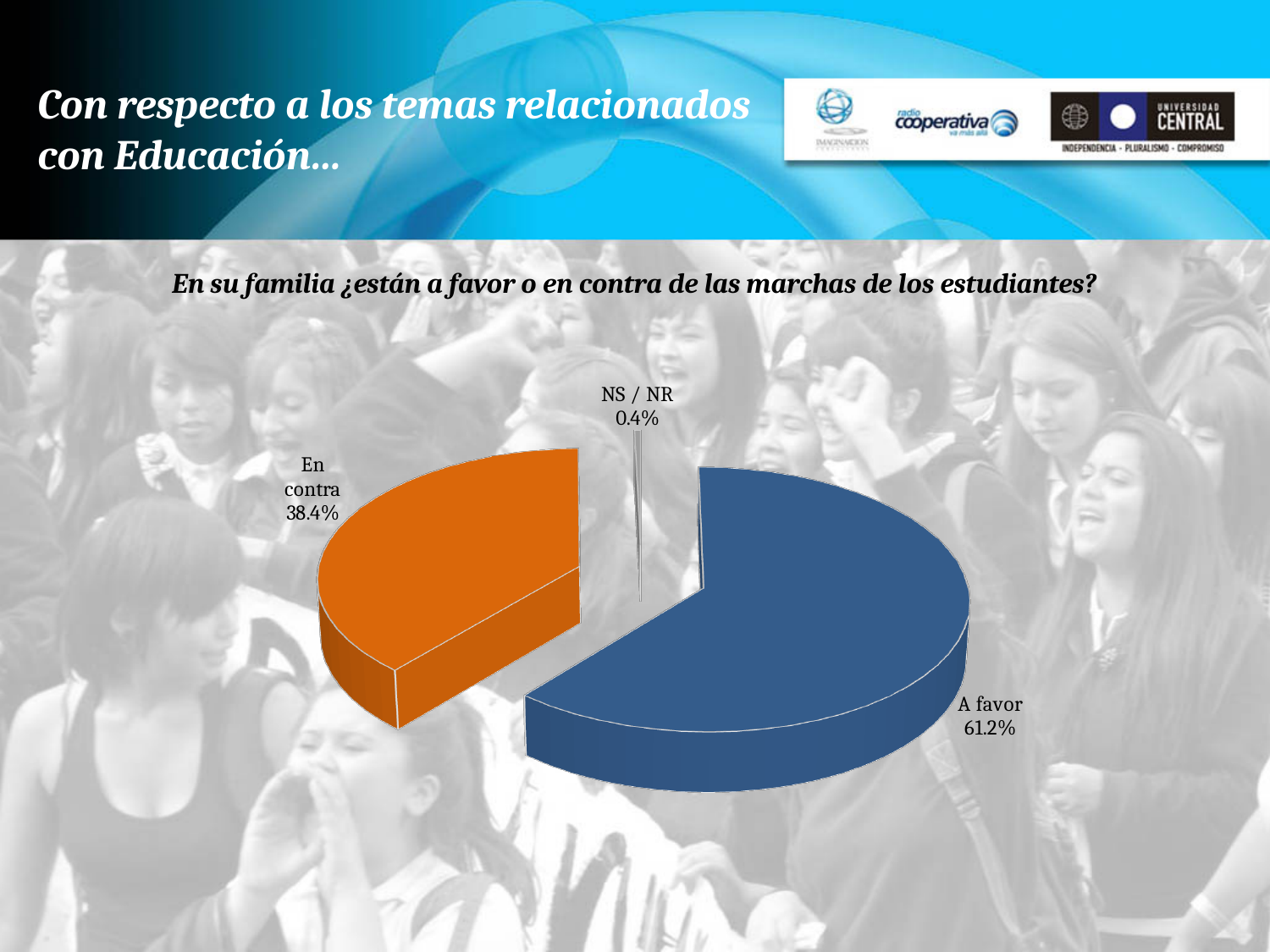
What is the difference in percentage points between "A favor" and "En contra"? 22.8 What colour is the "En contra" slice? Orange What question does the chart answer, according to the text above it? En su familia ¿están a favor o en contra de las marchas de los estudiantes? Which response has the largest share of the pie? A favor Which is larger, the share for "En contra" or the share for "NS / NR"? En contra How many categories are shown in the pie chart? 3 What percentage of respondents answered "NS / NR"? 0.4% What percentage of respondents answered "A favor"? 61.2% What kind of chart is shown on the slide? Pie chart Which response has the smallest share of the pie? NS / NR What percentage of respondents answered "En contra"? 38.4%